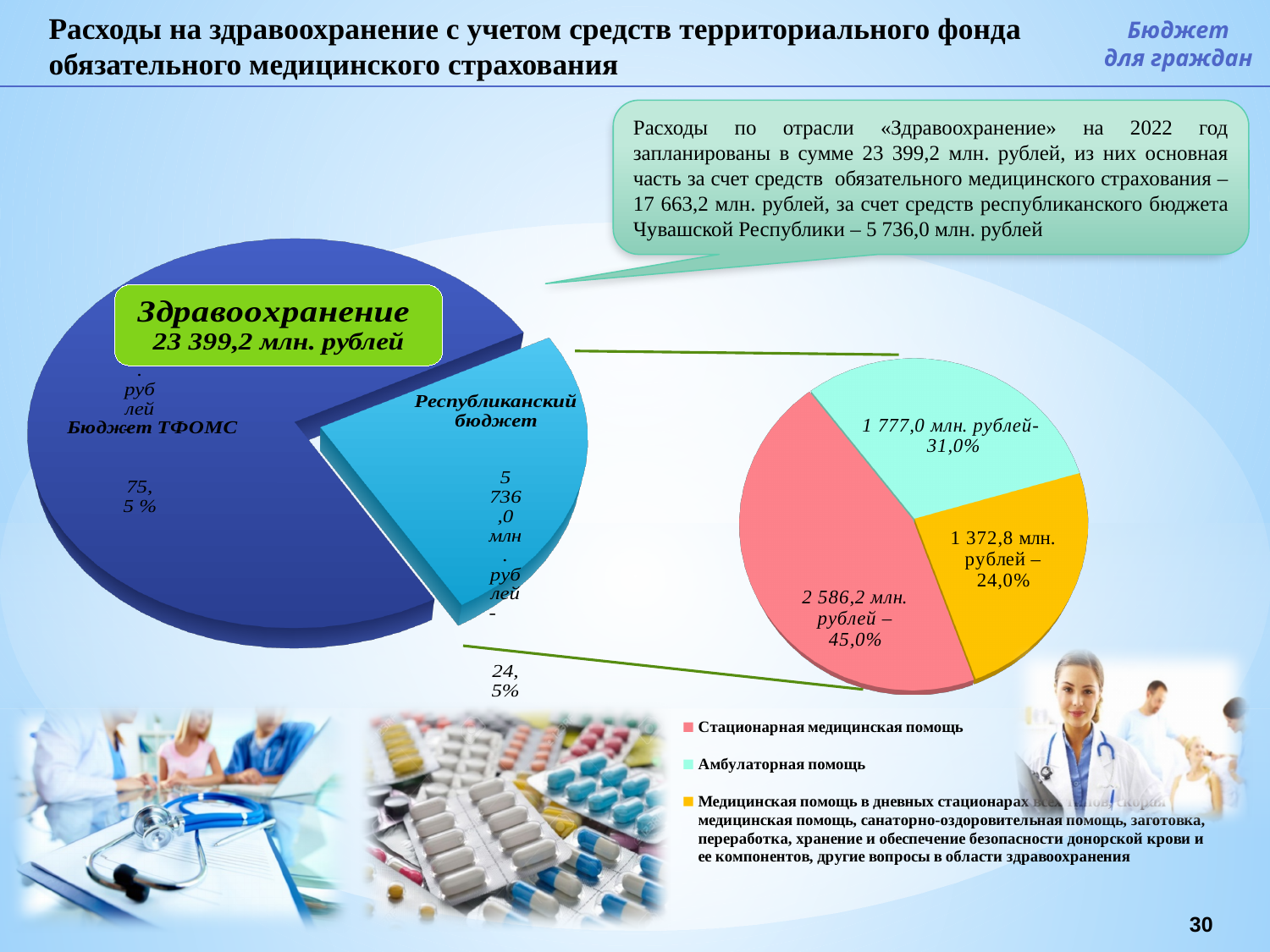
In the right pie chart, what value is shown for Стационарная медицинская помощь? 2 586,2 млн. рублей What type of chart is the left chart on the slide? pie chart In the left pie chart, what share does Бюджет ТФОМС have? 75,5 % In the left pie chart, what value in млн. рублей is shown for Республиканский бюджет? 5 736,0 млн. рублей In the left pie chart, which slice is larger: Бюджет ТФОМС or Республиканский бюджет? Бюджет ТФОМС In the right pie chart, which category has the largest share? Стационарная медицинская помощь In the right pie chart, what share does Амбулаторная помощь have? 31,0% How many entries does the legend of the right pie chart list? 3 How many slices does the left pie chart have? 2 In the left pie chart, what share does Республиканский бюджет have? 24,5% In the right pie chart, what is the difference in percentage points between Стационарная медицинская помощь and Амбулаторная помощь? 14,0 In the right pie chart, what value is shown for the yellow slice (Медицинская помощь в дневных стационарах...)? 1 372,8 млн. рублей